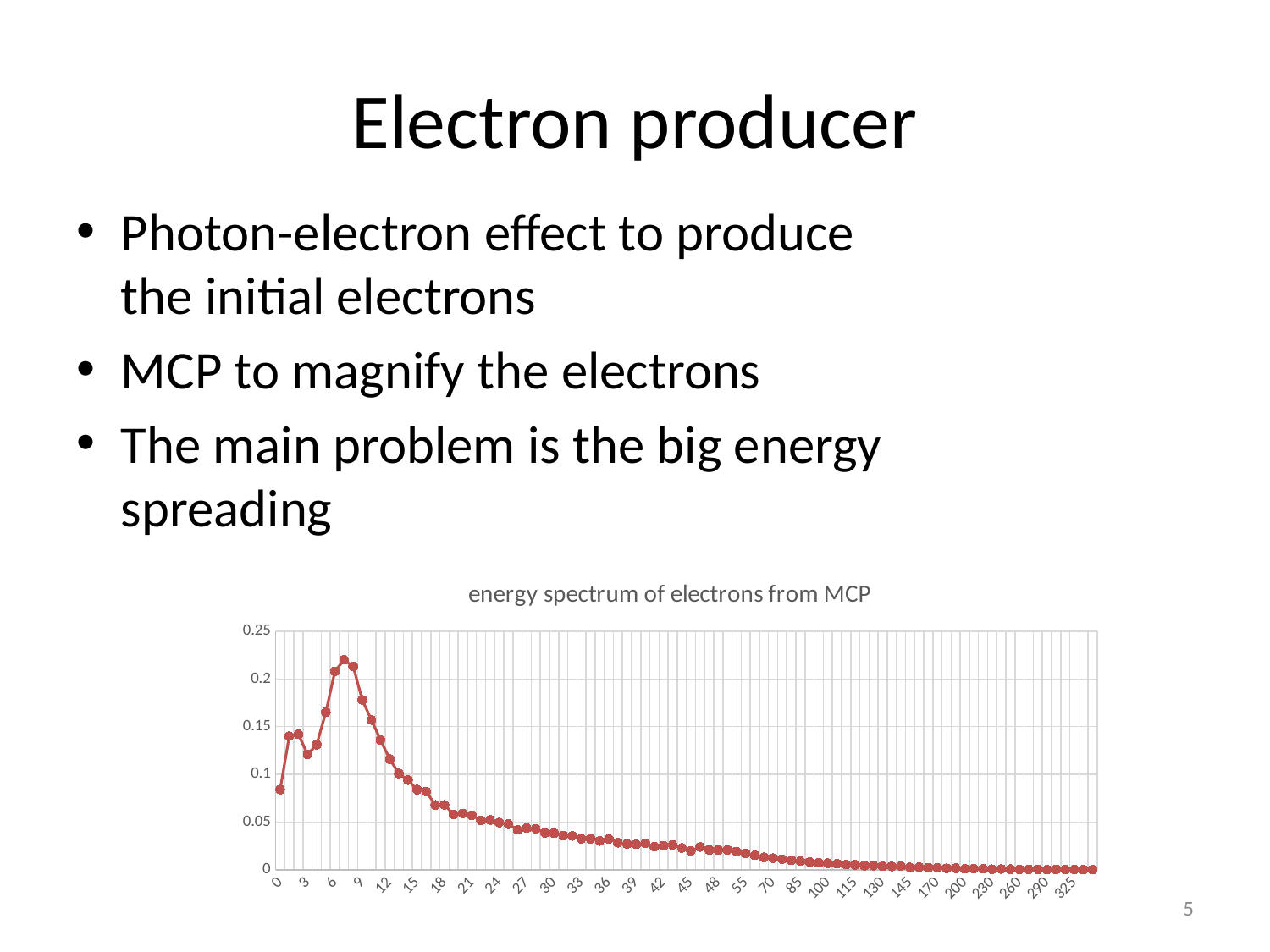
What is the highest value shown on the y axis of the chart? 0.25 After the peak near x = 6 to 9, do the values rise or fall as x increases? fall Is the value at x = 0 greater or less than 0.1? less Is the value at x = 325 greater or less than 0.05? less Is the value at x = 30 greater or less than 0.05? less What kind of chart is shown on the slide? line chart Which has the larger value, x = 9 or x = 30? x = 9 Which has the larger value, x = 3 or x = 100? x = 3 What is the title of the chart? energy spectrum of electrons from MCP